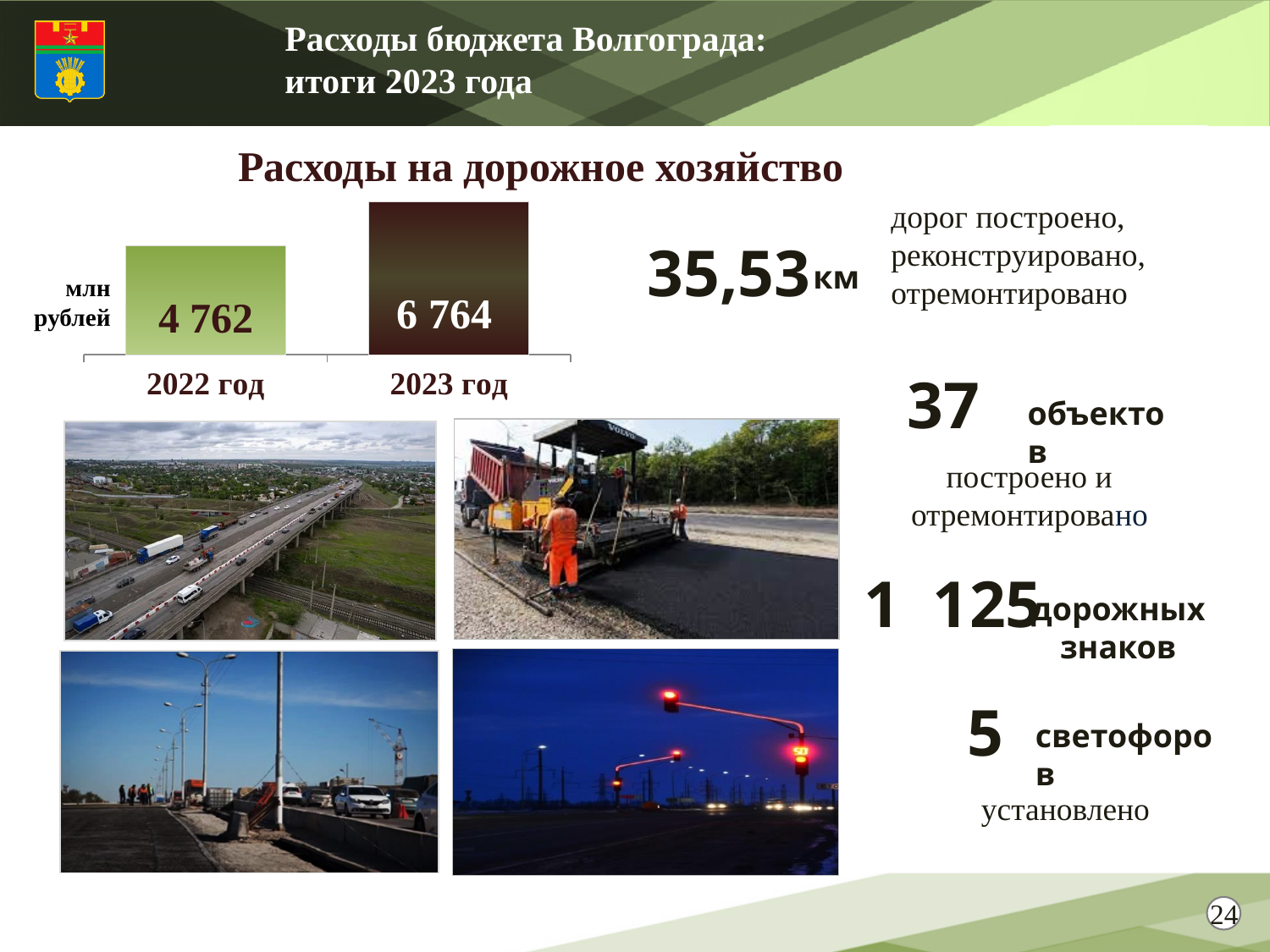
In what units are the chart values given? млн рублей Which year has the higher value in the chart? 2023 год Is the value for 2023 год larger or smaller than the value for 2022 год? larger Which year has the lower value in the chart? 2022 год What is the title of the chart? Расходы на дорожное хозяйство What is the value for 2022 год in the chart? 4 762 Do the values rise or fall from 2022 год to 2023 год? rise What is the value for 2023 год in the chart? 6 764 How many bars are shown in the chart? 2 What is the difference between the values for 2023 год and 2022 год? 2 002 What kind of chart is shown on the slide? bar chart